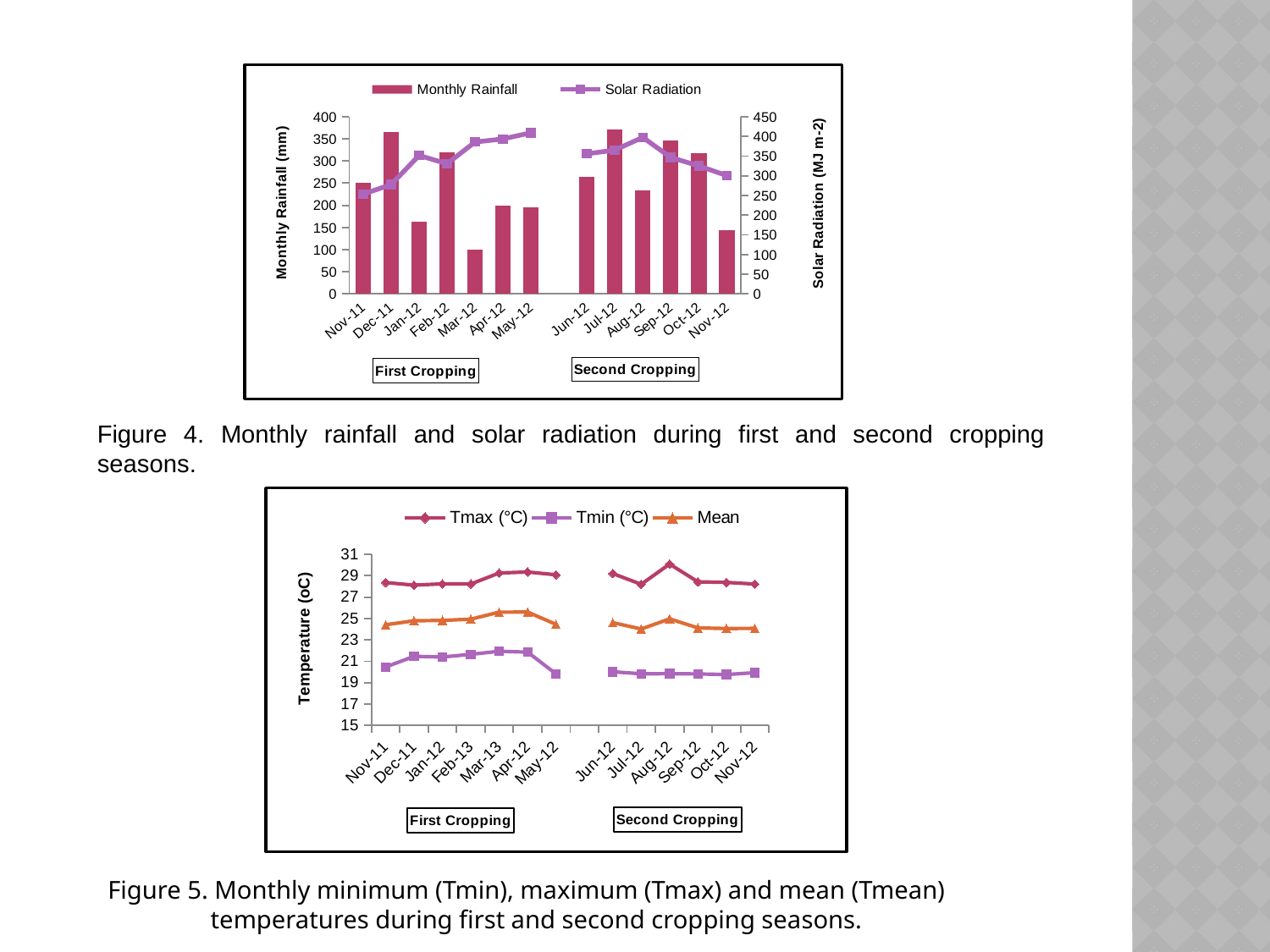
In the bottom chart (Figure 5), what kind of chart is it? line chart In the top chart (Figure 4), is the monthly rainfall for Mar-12 greater or less than 150? less In the top chart (Figure 4), does solar radiation rise or fall from Nov-11 to May-12 during the first cropping season? rise In the top chart (Figure 4), which is larger, the monthly rainfall for Dec-11 or for Jan-12? Dec-11 In the top chart (Figure 4), what is the title of the right-hand vertical axis? Solar Radiation (MJ m-2) In the bottom chart (Figure 5), how many series does the legend list? 3 In the bottom chart (Figure 5), is the Tmax value for Aug-12 greater or less than 29? greater In the top chart (Figure 4), which month has the lowest monthly rainfall? Mar-12 In the top chart (Figure 4), how many months are shown on the x axis in total? 13 In the top chart (Figure 4), which month has the lowest solar radiation? Nov-11 In the top chart (Figure 4), is the monthly rainfall for Dec-11 greater or less than 300? greater In the top chart (Figure 4), how many series does the legend list? 2